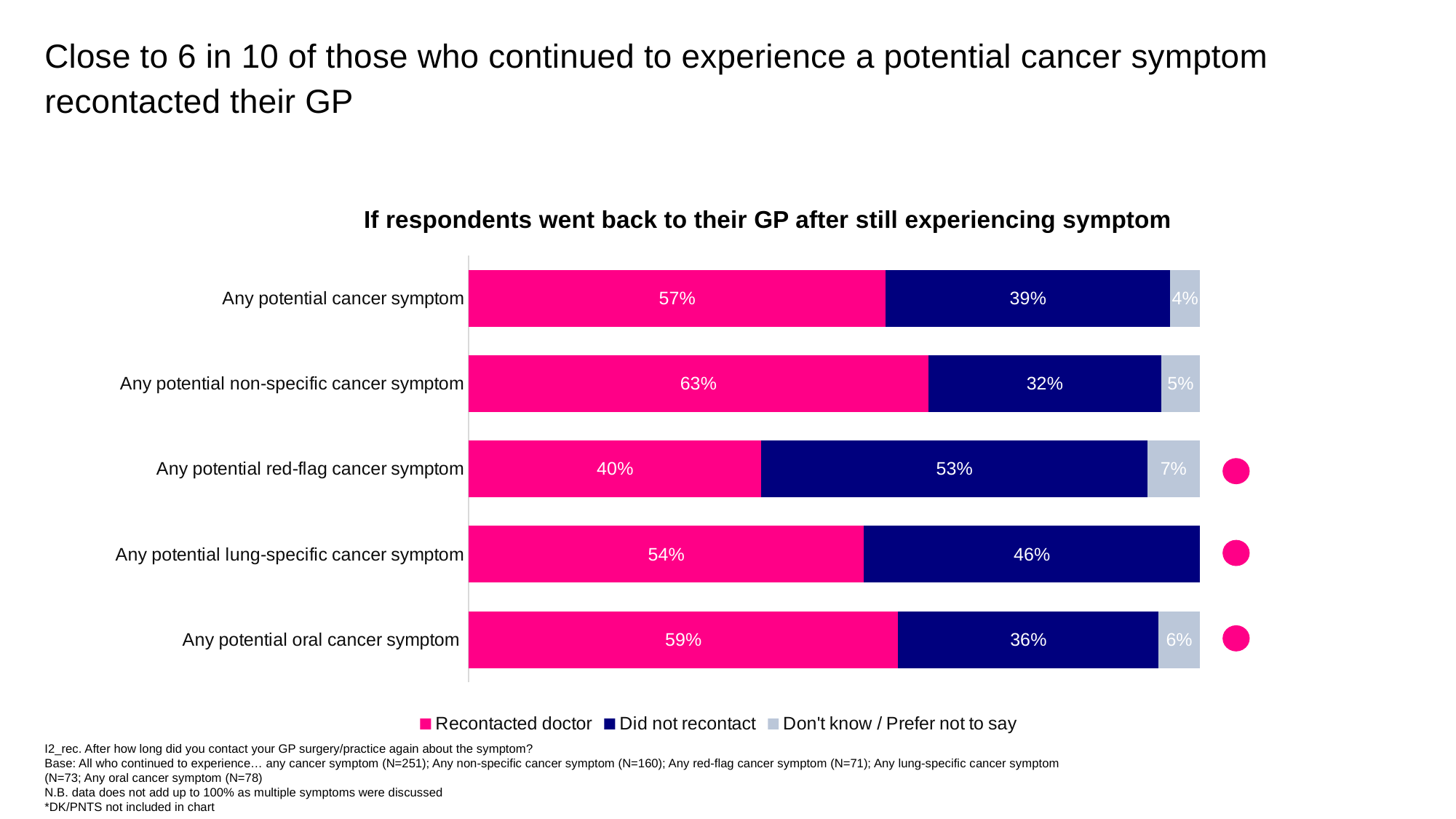
How many symptom categories are shown in the chart? 5 What is the title of the chart? If respondents went back to their GP after still experiencing symptom What percentage of respondents with any potential red-flag cancer symptom did not recontact their GP? 53% What type of chart is shown on the slide? Stacked bar chart What percentage of respondents with any potential non-specific cancer symptom recontacted their doctor? 63% What is the 'Don't know / Prefer not to say' value for any potential oral cancer symptom? 6% What is the total of the stacked bar for any potential cancer symptom? 100% What is the difference between the 'Recontacted doctor' percentages for any potential non-specific cancer symptom and any potential red-flag cancer symptom? 23 percentage points Which symptom category has the lowest share of respondents who recontacted their doctor? Any potential red-flag cancer symptom Which symptom category has the highest share of respondents who recontacted their doctor? Any potential non-specific cancer symptom How many series does the legend list? 3 For any potential lung-specific cancer symptom, which is larger: the share who recontacted the doctor or the share who did not recontact? Recontacted doctor